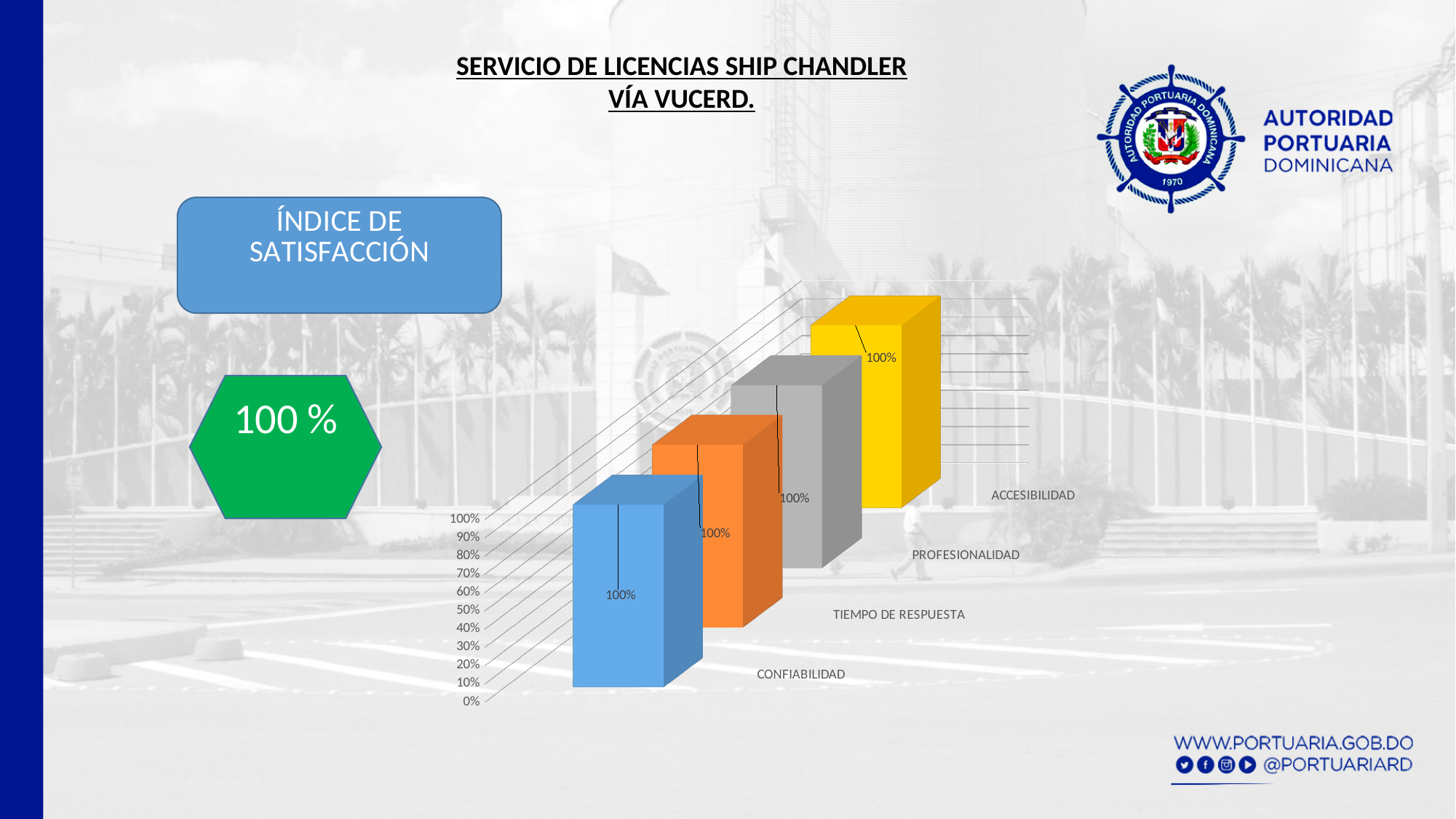
Is the value for CONFIABILIDAD greater or less than 50%? greater What is the value for PROFESIONALIDAD? 100% Is the value for ACCESIBILIDAD greater or less than 90%? greater What is the difference between the values for ACCESIBILIDAD and CONFIABILIDAD? 0% What kind of chart is shown on the slide? bar chart Do the values change from CONFIABILIDAD to ACCESIBILIDAD, or stay the same? stay the same What is the value for CONFIABILIDAD? 100% What is the value for ACCESIBILIDAD? 100% What colour is the bar for ACCESIBILIDAD? yellow What is the highest tick shown on the vertical axis? 100% How many categories are plotted in the chart? 4 What is the value for TIEMPO DE RESPUESTA? 100%